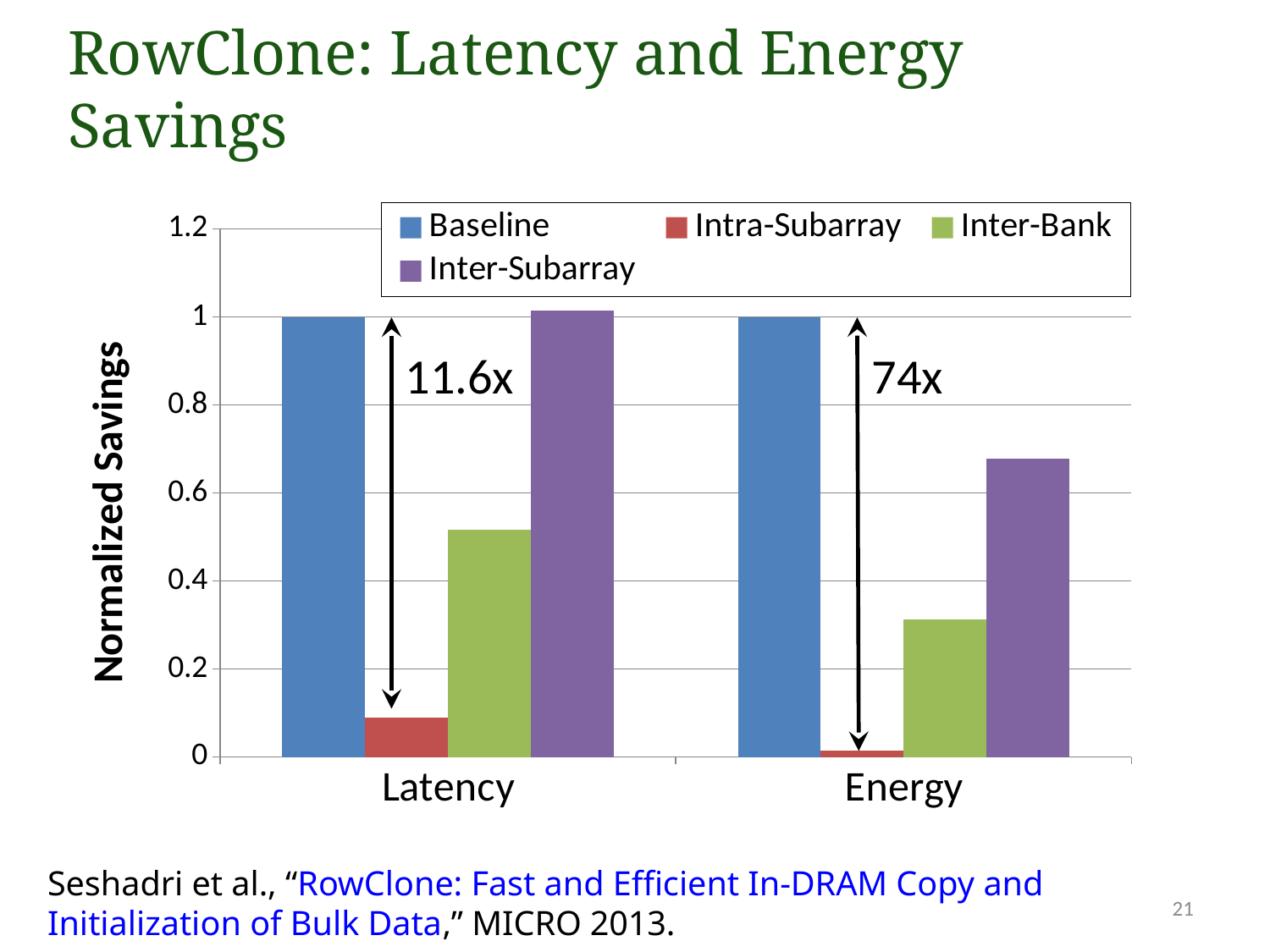
Is the Intra-Subarray value for Latency greater or less than 0.2? less How many series does the legend list? 4 What improvement factor is annotated above the Energy bars? 74x Which series has the lowest value for Energy? Intra-Subarray Is the Inter-Bank value larger for Latency or for Energy? Latency Is the Inter-Bank value for Energy greater or less than 0.4? less What is the Baseline value for Latency? 1 What is the Baseline value for Energy? 1 Is the Inter-Bank value for Latency greater or less than 0.4? greater What kind of chart is shown on the slide? bar chart How many categories are shown on the x axis? 2